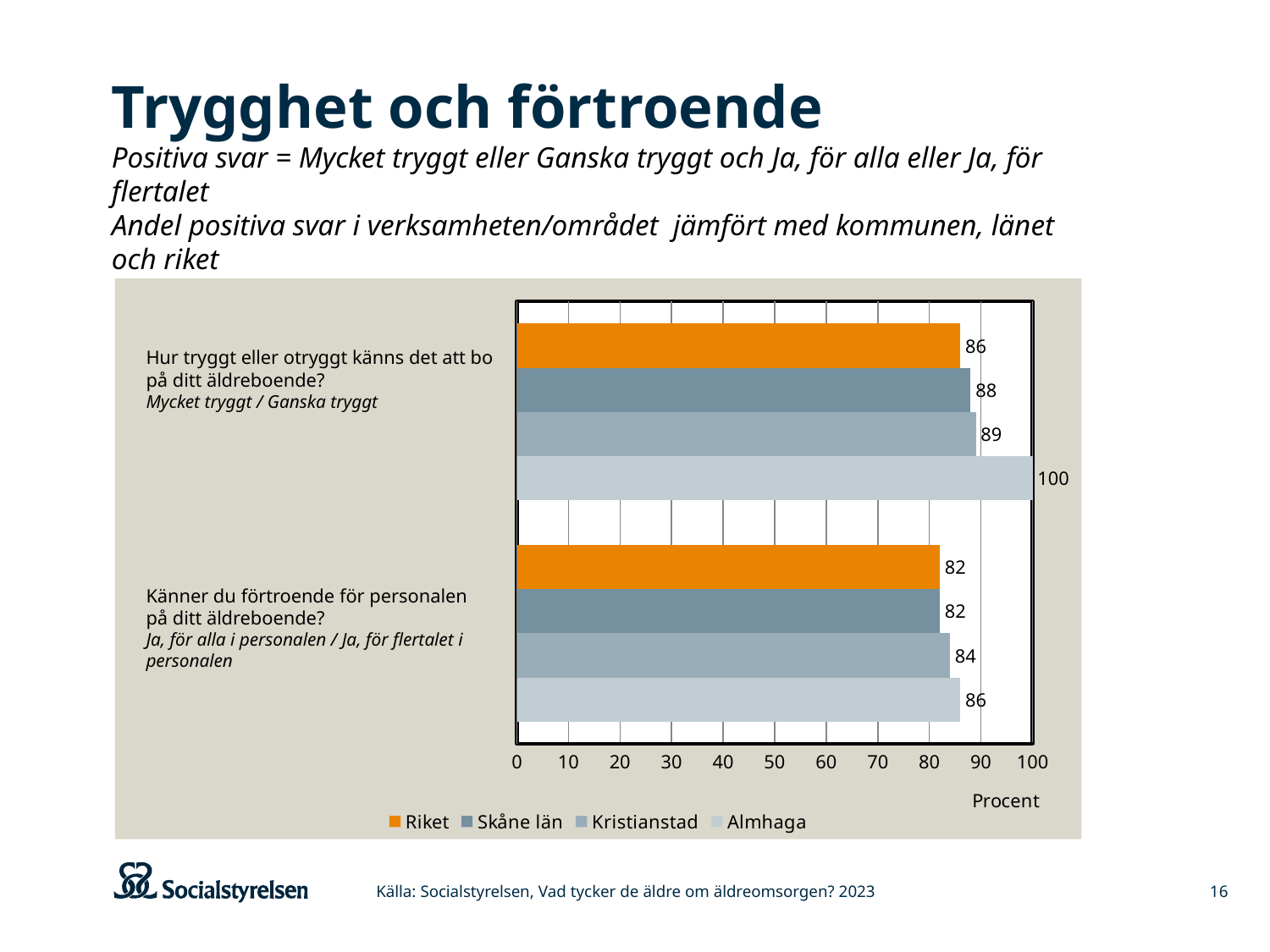
What is the difference between Almhaga and Riket on the question "Hur tryggt eller otryggt känns det att bo på ditt äldreboende?"? 14 Which series has the highest value on the question "Hur tryggt eller otryggt känns det att bo på ditt äldreboende?"? Almhaga What is the label of the x axis? Procent Which series has the lowest value on the question "Hur tryggt eller otryggt känns det att bo på ditt äldreboende?"? Riket What is the value for Riket on the question "Känner du förtroende för personalen på ditt äldreboende?"? 82 What is the difference between Almhaga and Kristianstad on the question "Känner du förtroende för personalen på ditt äldreboende?"? 2 What kind of chart is shown on the slide? Bar chart What is the value for Kristianstad on the question "Hur tryggt eller otryggt känns det att bo på ditt äldreboende?"? 89 How many series does the legend list? 4 What is the value for Skåne län on the question "Känner du förtroende för personalen på ditt äldreboende?"? 82 What is the value for Almhaga on the question "Hur tryggt eller otryggt känns det att bo på ditt äldreboende?"? 100 Which is larger on the question "Känner du förtroende för personalen på ditt äldreboende?": Kristianstad or Riket? Kristianstad